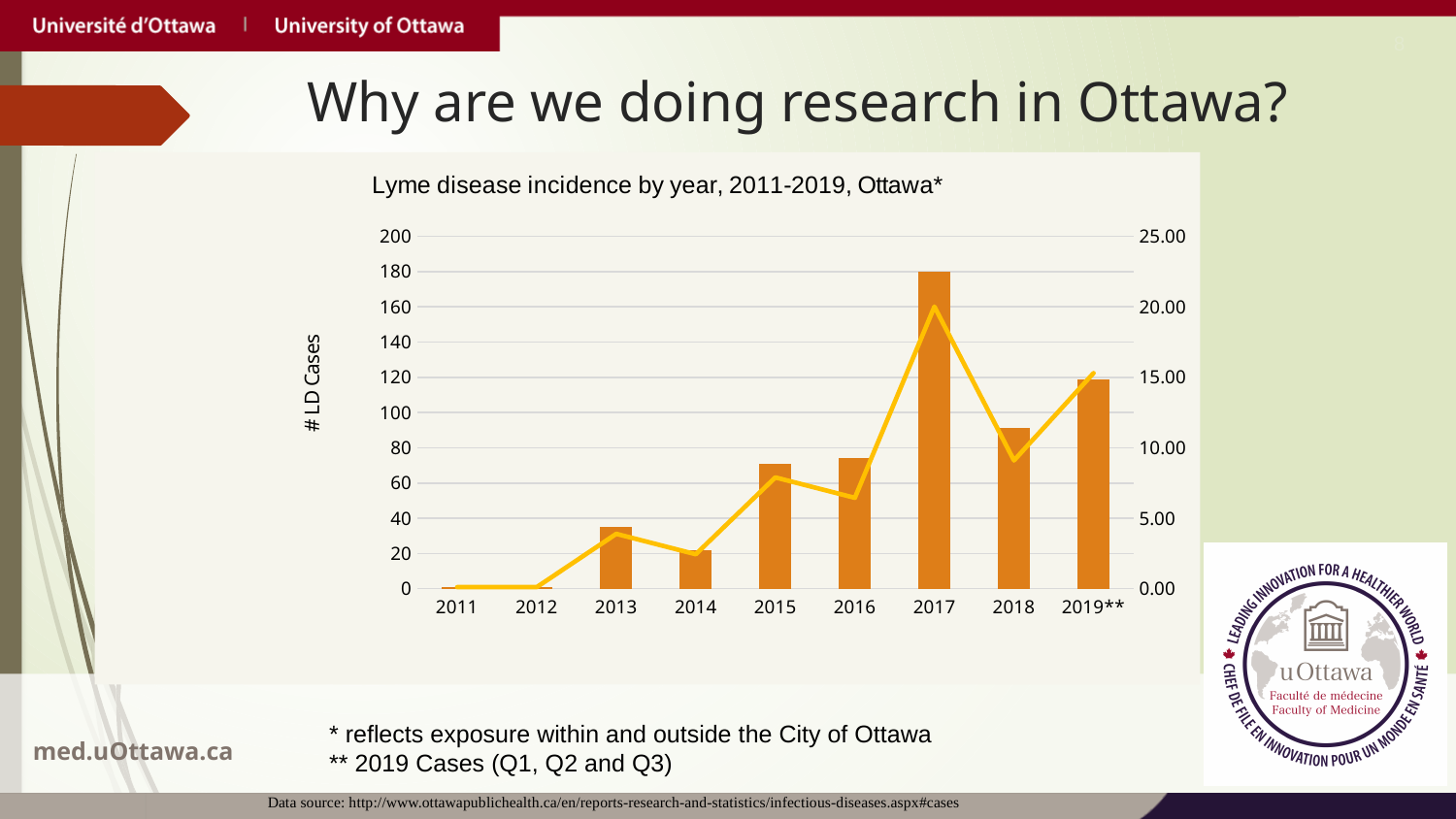
Which year has more LD cases, 2018 or 2019**? 2019** What kind of chart is shown on the slide? bar chart with a line How many years are shown on the x axis of the chart? 9 Is the number of LD cases for 2018 greater or less than 100? less What is the title of the chart? Lyme disease incidence by year, 2011-2019, Ottawa* What is the label on the left vertical axis of the chart? # LD Cases Is the number of LD cases for 2019** greater or less than 100? greater Is the number of LD cases for 2013 greater or less than 40? less Which year has more LD cases, 2013 or 2014? 2013 Do the number of LD cases rise or fall from 2014 to 2017? rise Which year has the highest number of LD cases? 2017